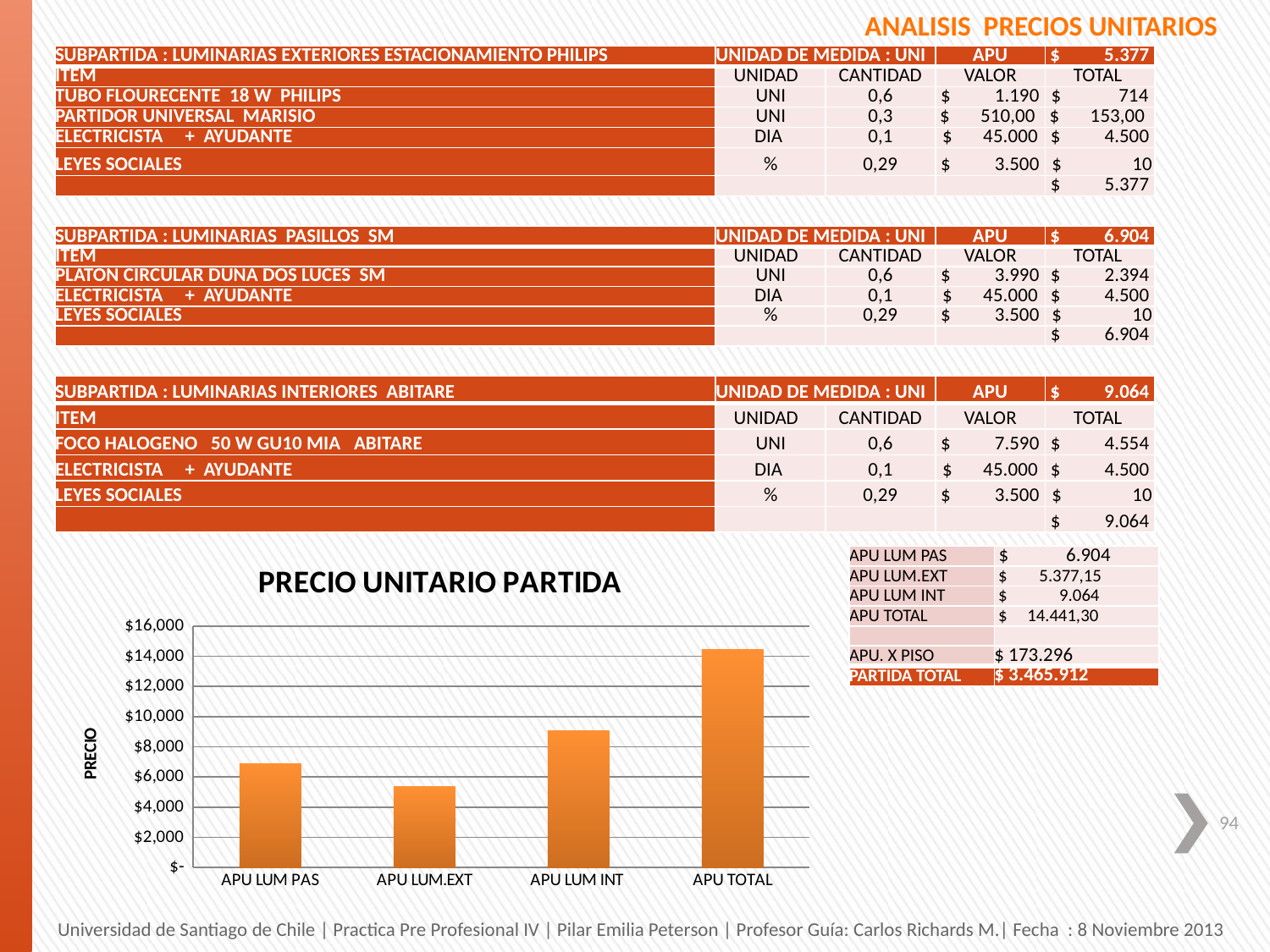
Which category has the highest bar in the PRECIO UNITARIO PARTIDA chart? APU TOTAL Is the value for APU TOTAL greater or less than $12,000? greater Is the value for APU LUM.EXT greater or less than $6,000? less In the chart, which is larger: the value for APU LUM PAS or the value for APU LUM.EXT? APU LUM PAS What is the label on the vertical axis of the chart? PRECIO How many categories are plotted in the PRECIO UNITARIO PARTIDA chart? 4 Is the value for APU LUM INT greater or less than $10,000? less What is the title of the chart on the slide? PRECIO UNITARIO PARTIDA Which category has the lowest bar in the PRECIO UNITARIO PARTIDA chart? APU LUM.EXT In the chart, which is larger: the value for APU LUM PAS or the value for APU LUM INT? APU LUM INT What kind of chart is shown on the slide? bar chart